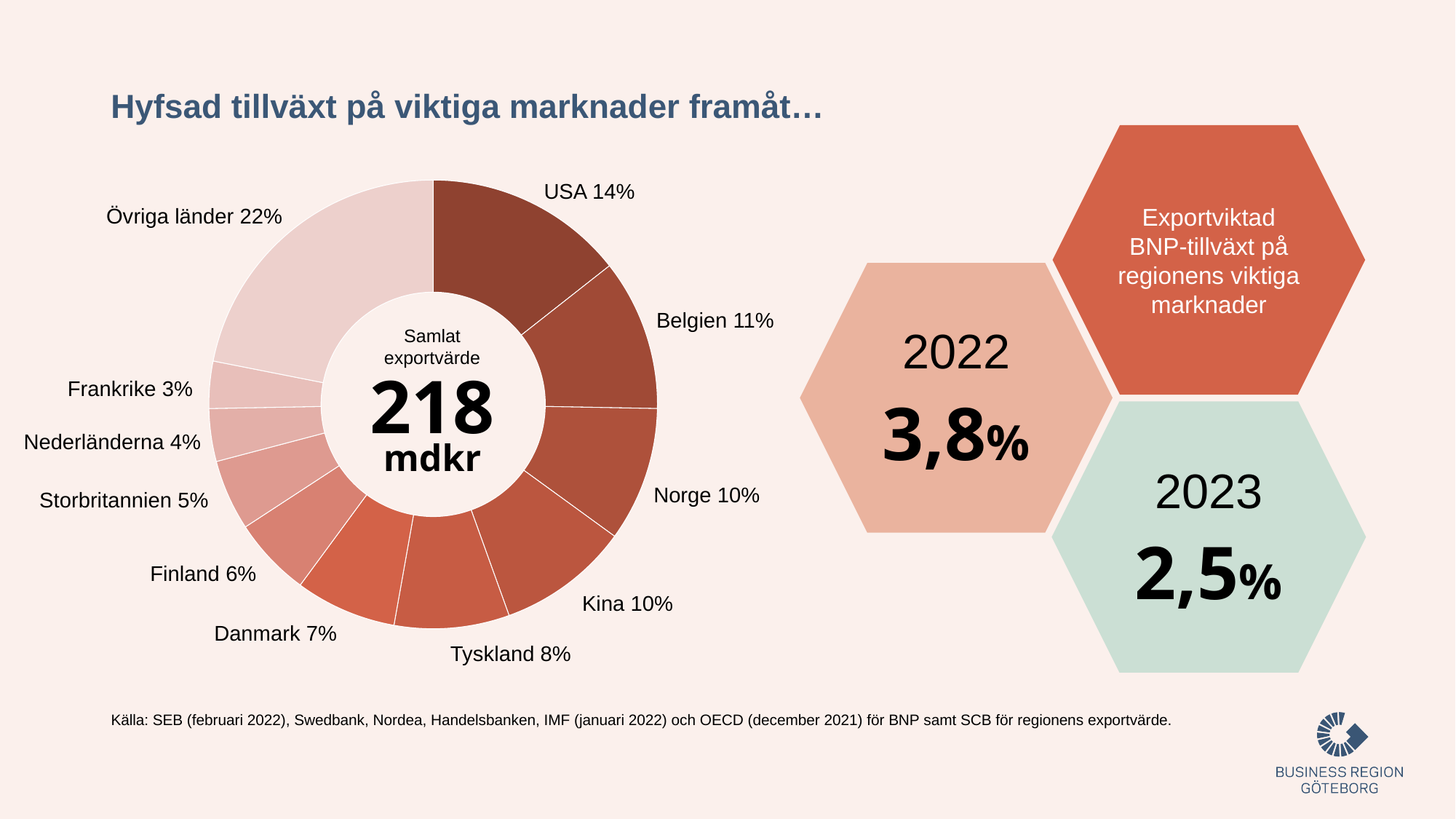
What share of the export value does USA account for in the donut chart? 14% What is the difference in percentage points between USA and Belgien in the donut chart? 3 What percentage is shown for Storbritannien in the donut chart? 5% Which slice of the donut chart has the largest share? Övriga länder What percentage is shown for Tyskland in the donut chart? 8% What is the difference in percentage points between Övriga länder and Danmark in the donut chart? 15 How many slices does the donut chart have? 11 What kind of chart is shown on the slide? Donut (pie) chart Which has a larger share in the donut chart, Finland or Nederländerna? Finland Which individually named country has the largest share in the donut chart? USA Which slice of the donut chart has the smallest share? Frankrike What total export value is printed in the centre of the donut chart? 218 mdkr